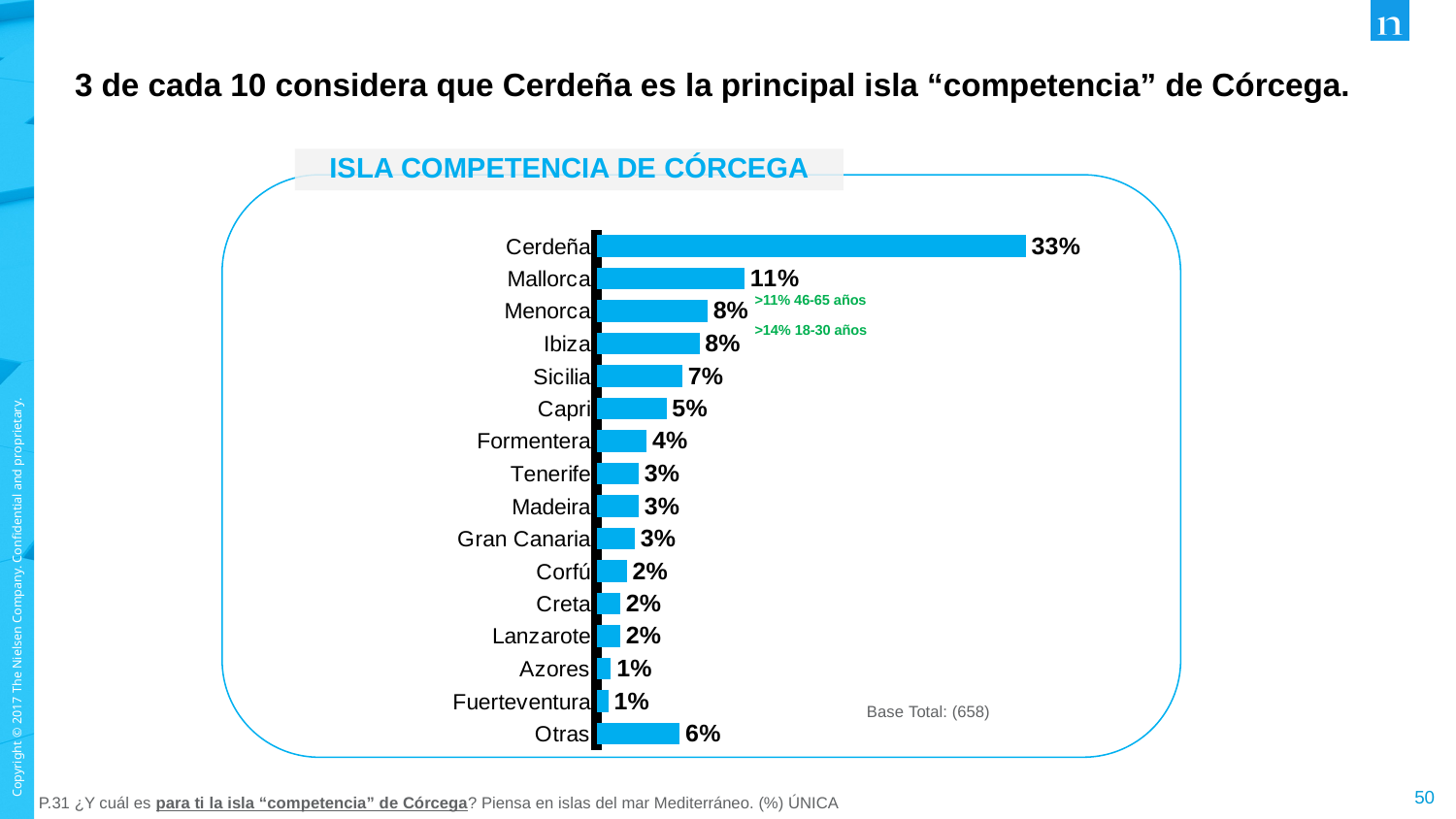
What is the difference between the values for Sicilia and Capri? 2% What is the title of the chart? ISLA COMPETENCIA DE CÓRCEGA What is the value for Sicilia? 7% What is the value for Otras? 6% What is the base total shown on the chart? 658 What is the value for Mallorca? 11% How many categories are shown in the chart? 16 Which island has the highest value? Cerdeña What is the difference between the values for Cerdeña and Mallorca? 22% Which is larger, the value for Formentera or the value for Tenerife? Formentera What kind of chart is shown on the slide? Bar chart What is the value for Cerdeña? 33%